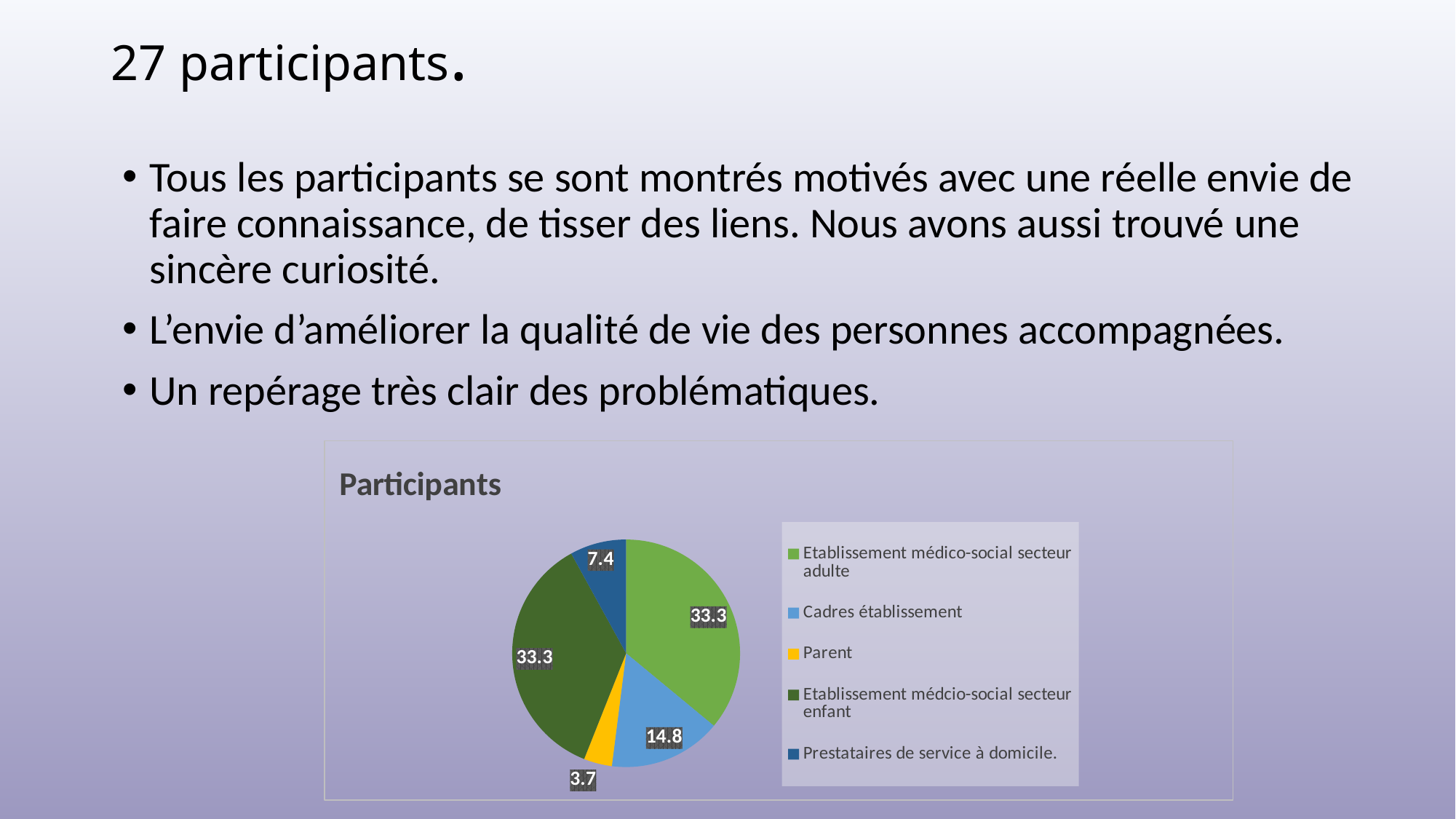
What colour is the slice for Parent? yellow What is the difference between the values for Cadres établissement and Prestataires de service à domicile? 7.4 Which is larger, the slice for Cadres établissement or the slice for Prestataires de service à domicile? Cadres établissement What is the value shown for Etablissement médico-social secteur adulte? 33.3 How many entries does the legend list? 5 Which category has the smallest slice of the pie? Parent How many slices does the pie chart have? 5 What is the title of the chart? Participants What is the value shown for Cadres établissement? 14.8 What is the value shown for Prestataires de service à domicile? 7.4 What kind of chart is shown on the slide? pie chart What is the value shown for Parent? 3.7